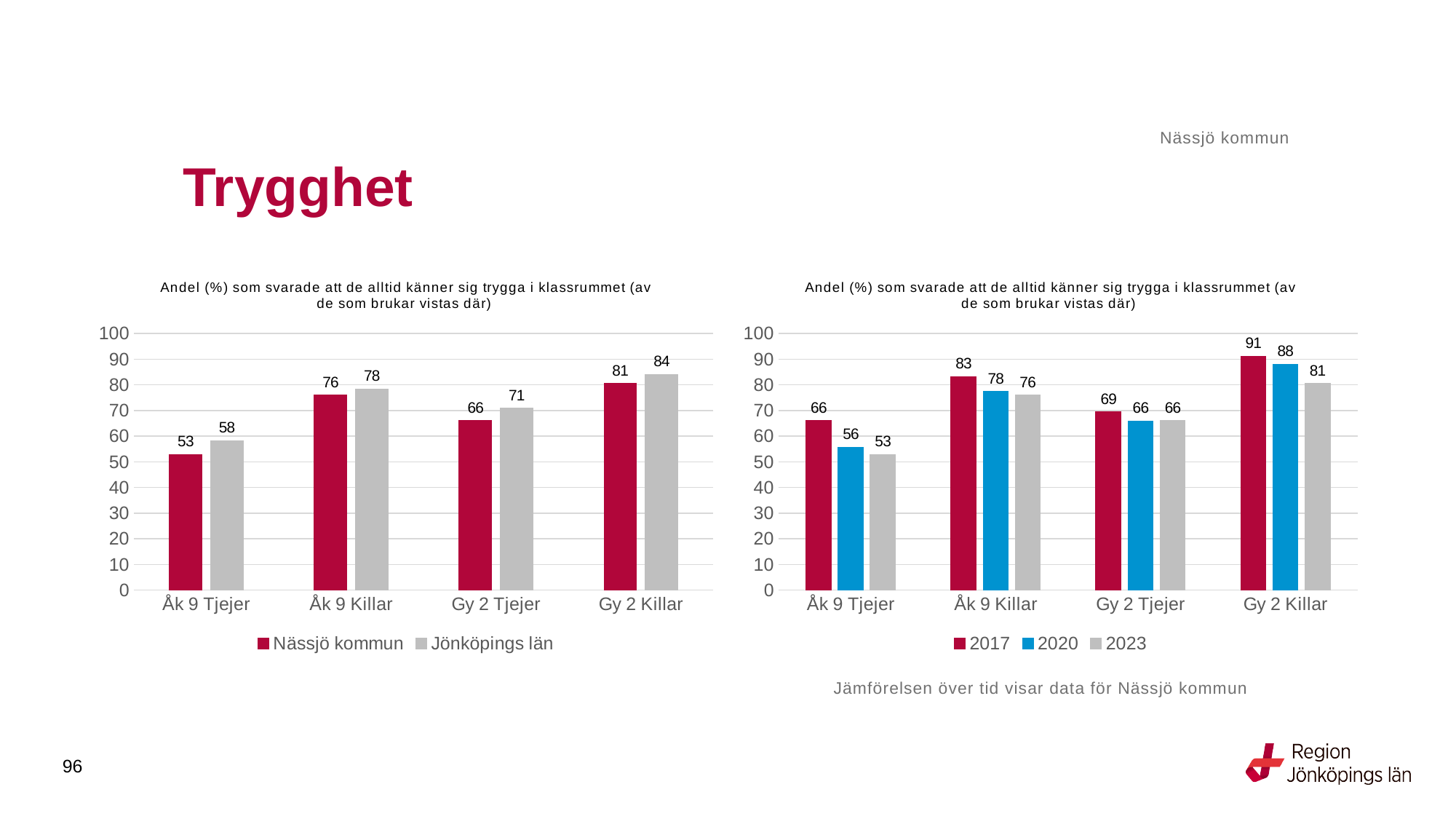
In the left chart, what is the difference between Jönköpings län and Nässjö kommun for Gy 2 Tjejer? 5 In the right chart, which is larger for Gy 2 Tjejer: the 2017 value or the 2020 value? 2017 In the left chart, which category has the lowest value for Nässjö kommun? Åk 9 Tjejer What kind of chart is the right chart? Bar chart In the left chart, what is the value for Jönköpings län for Gy 2 Killar? 84 In the right chart, what is the value for 2023 for Gy 2 Killar? 81 In the right chart, what is the difference between the 2017 and 2023 values for Åk 9 Tjejer? 13 In the left chart, how many series does the legend list? 2 In the left chart, what is the value for Nässjö kommun for Åk 9 Tjejer? 53 In the right chart, what is the value for 2020 for Åk 9 Killar? 78 In the right chart, which category has the highest value for 2017? Gy 2 Killar In the right chart, how many categories are shown on the x axis? 4